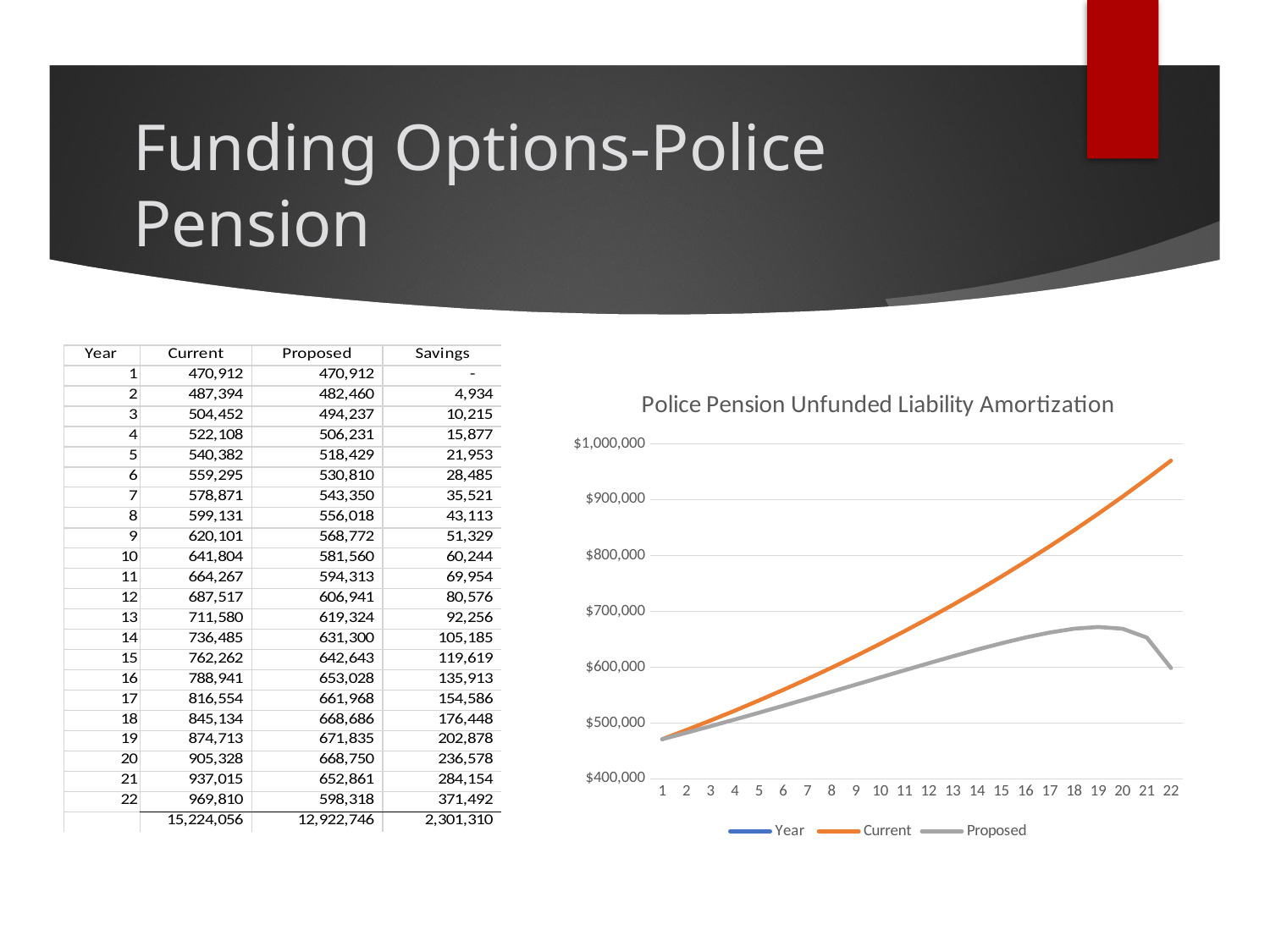
Does the Current line rise or fall from year 1 to year 22? rise In which year does the Current series reach its highest value? 22 Is the Proposed value at year 19 greater or less than $600,000? greater Is the Current value at year 1 greater or less than $500,000? less How many years are plotted along the x axis of the chart? 22 At year 22, which series is larger, Current or Proposed? Current What is the title of the chart? Police Pension Unfunded Liability Amortization Is the Current value at year 22 greater or less than $900,000? greater According to the table, what is the Current value for year 22? 969,810 What type of chart is shown on the slide? line chart According to the table, what is the Proposed value for year 22? 598,318 How many series does the chart legend list? 3